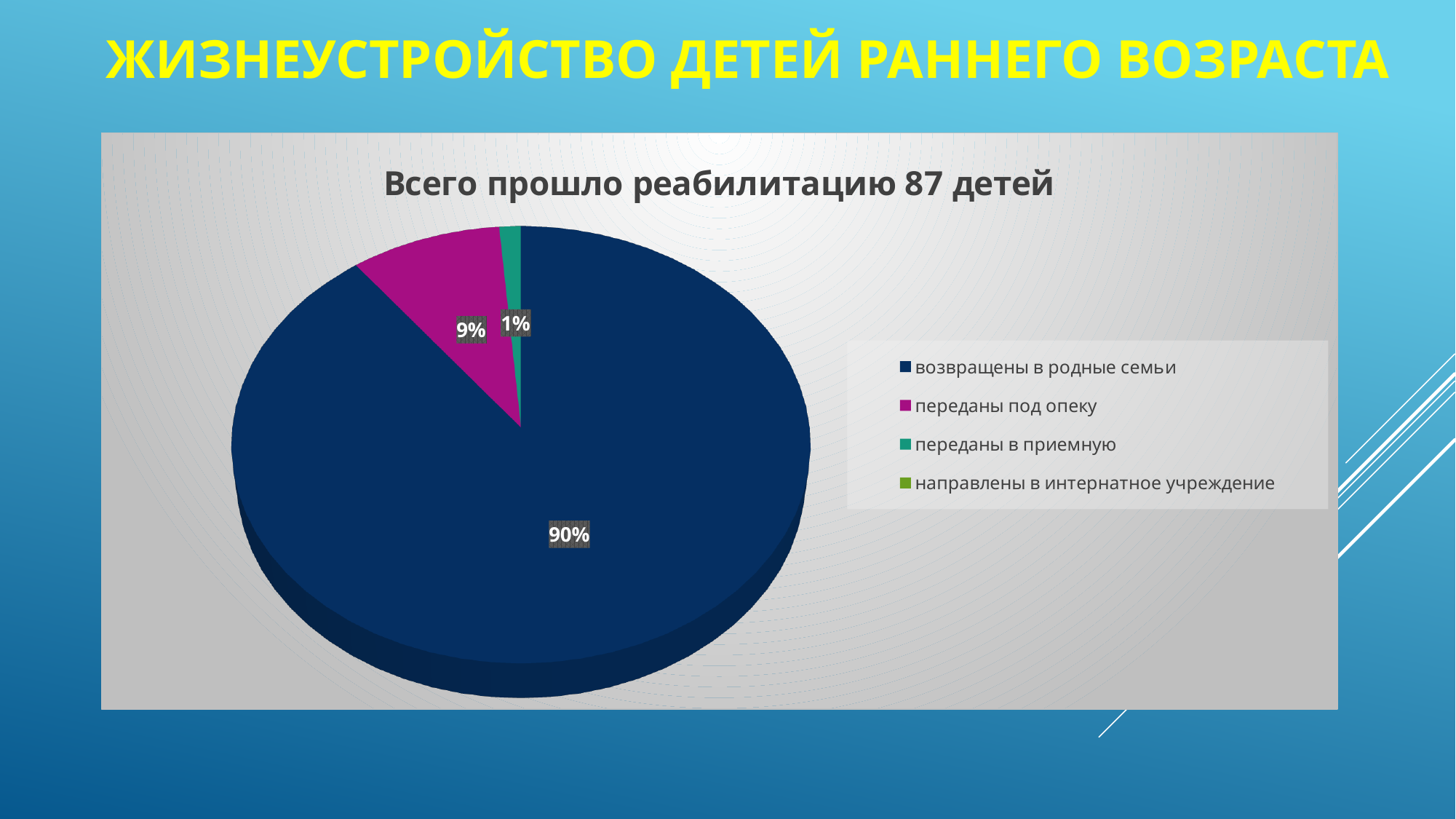
What share of the pie is labelled for 'переданы в приемную'? 1% Which slice is larger: 'переданы под опеку' or 'переданы в приемную'? переданы под опеку What share of the pie is labelled for 'переданы под опеку'? 9% Is the share for 'возвращены в родные семьи' greater or less than 50%? greater Which of the labelled slices is the smallest? переданы в приемную How many categories does the legend list? 4 Which category has the largest slice of the pie? возвращены в родные семьи What is the chart's title? Всего прошло реабилитацию 87 детей What share of the pie is labelled for 'возвращены в родные семьи'? 90% What colour is the slice for 'переданы под опеку'? Magenta (purple) What kind of chart is shown on the slide? Pie chart By how many percentage points does the 'возвращены в родные семьи' slice exceed the 'переданы под опеку' slice? 81 percentage points